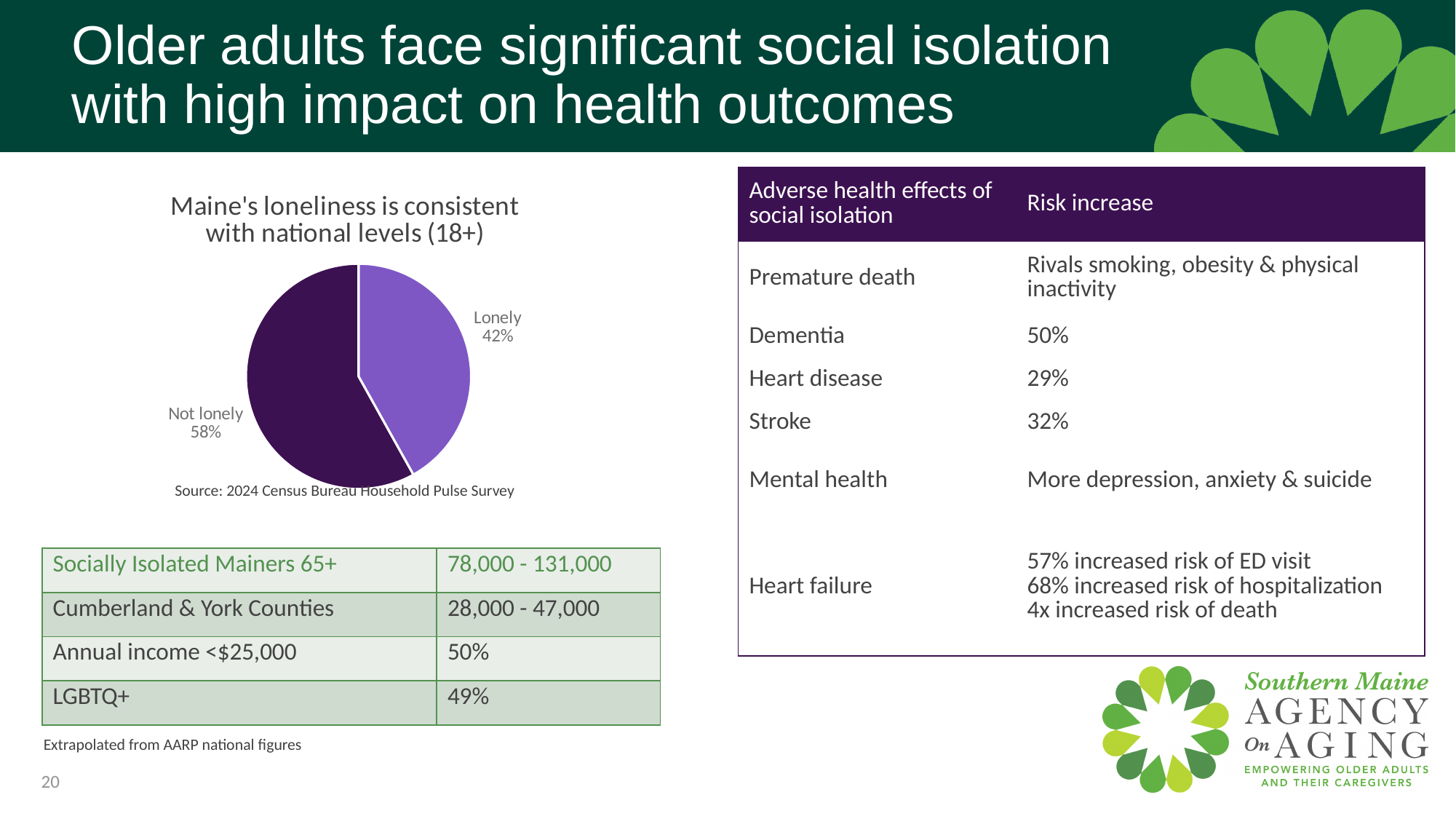
What share of the pie is labelled Not lonely? 58% Which slice of the pie chart is the smallest? Lonely How many slices does the pie chart have? 2 Is the Lonely share greater or less than 50%? less What is the title of the pie chart? Maine's loneliness is consistent with national levels (18+) What source is cited below the pie chart? 2024 Census Bureau Household Pulse Survey What is the difference in percentage points between the Not lonely and Lonely slices? 16 Which is larger, the Lonely slice or the Not lonely slice? Not lonely What share of the pie is labelled Lonely? 42% What kind of chart is shown on the slide? pie chart Which slice of the pie chart is the largest? Not lonely